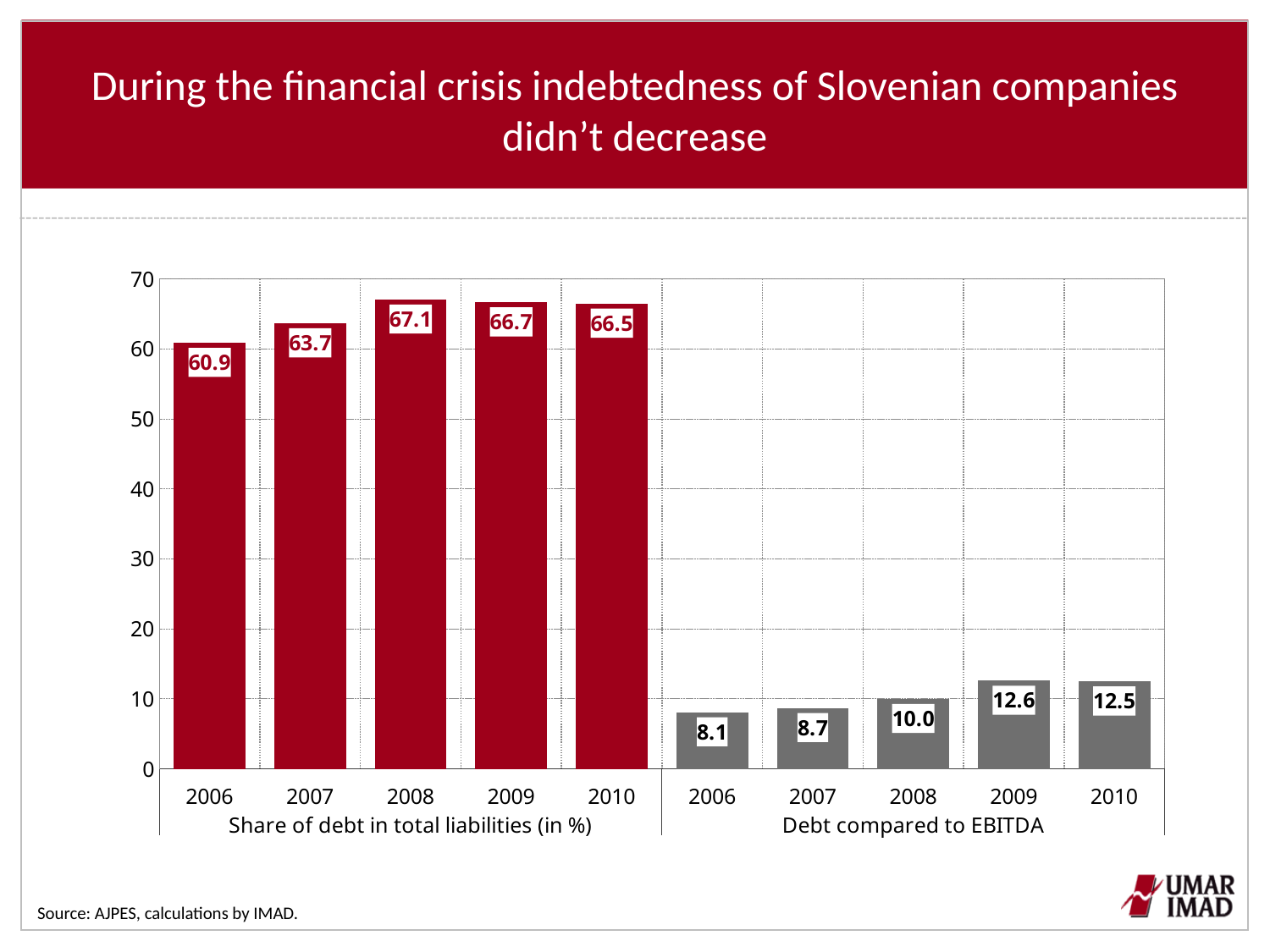
What is the difference between debt compared to EBITDA in 2009 and in 2006? 4.5 In which year is debt compared to EBITDA lowest? 2006 Which is larger: the share of debt in total liabilities in 2007 or in 2009? 2009 What is the difference between the share of debt in total liabilities in 2008 and in 2006? 6.2 What is the value of debt compared to EBITDA in 2009? 12.6 What kind of chart is shown on the slide? Bar chart Is the value for debt compared to EBITDA in 2008 greater or less than 20? less What is the share of debt in total liabilities in 2010? 66.5 Does debt compared to EBITDA rise or fall from 2006 to 2009? Rise In which year is the share of debt in total liabilities highest? 2008 What is the share of debt in total liabilities in 2006? 60.9 How many years are shown for the 'Debt compared to EBITDA' group? 5